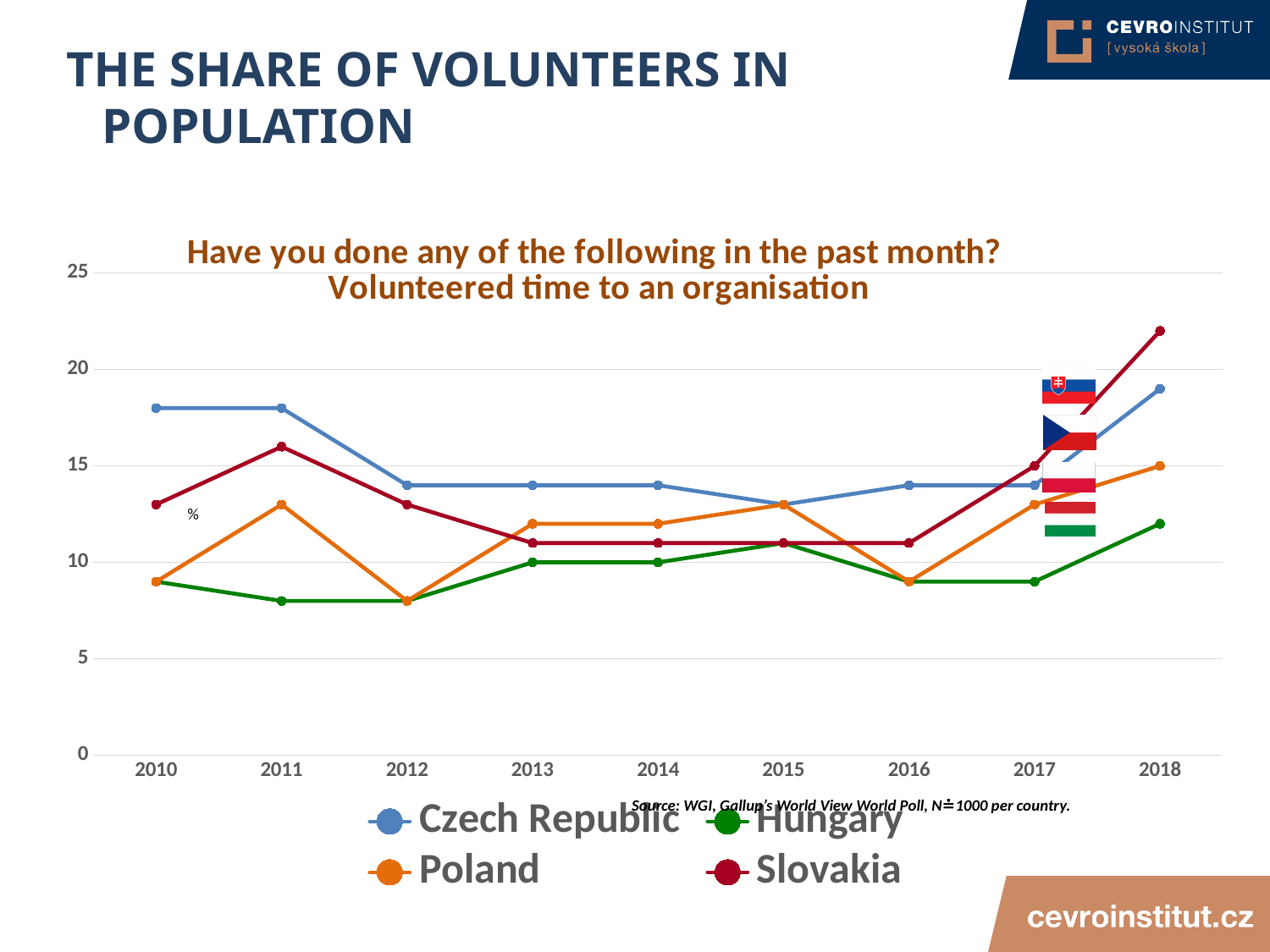
How many years are shown on the x axis? 9 How many series does the legend list? 4 Which country has the lowest value in 2018? Hungary In 2011, which is larger, the value for Slovakia or the value for Poland? Slovakia Which country has the highest value in 2018? Slovakia Which country has the highest value in 2010? Czech Republic Is the value for the Czech Republic in 2010 greater or less than 15? greater What is the title of the chart? Have you done any of the following in the past month? Volunteered time to an organisation What kind of chart is shown on the slide? line chart Is the value for Slovakia in 2018 greater or less than 20? greater Does the value for Slovakia rise or fall from 2016 to 2018? rise Is the value for Hungary in 2011 greater or less than 10? less